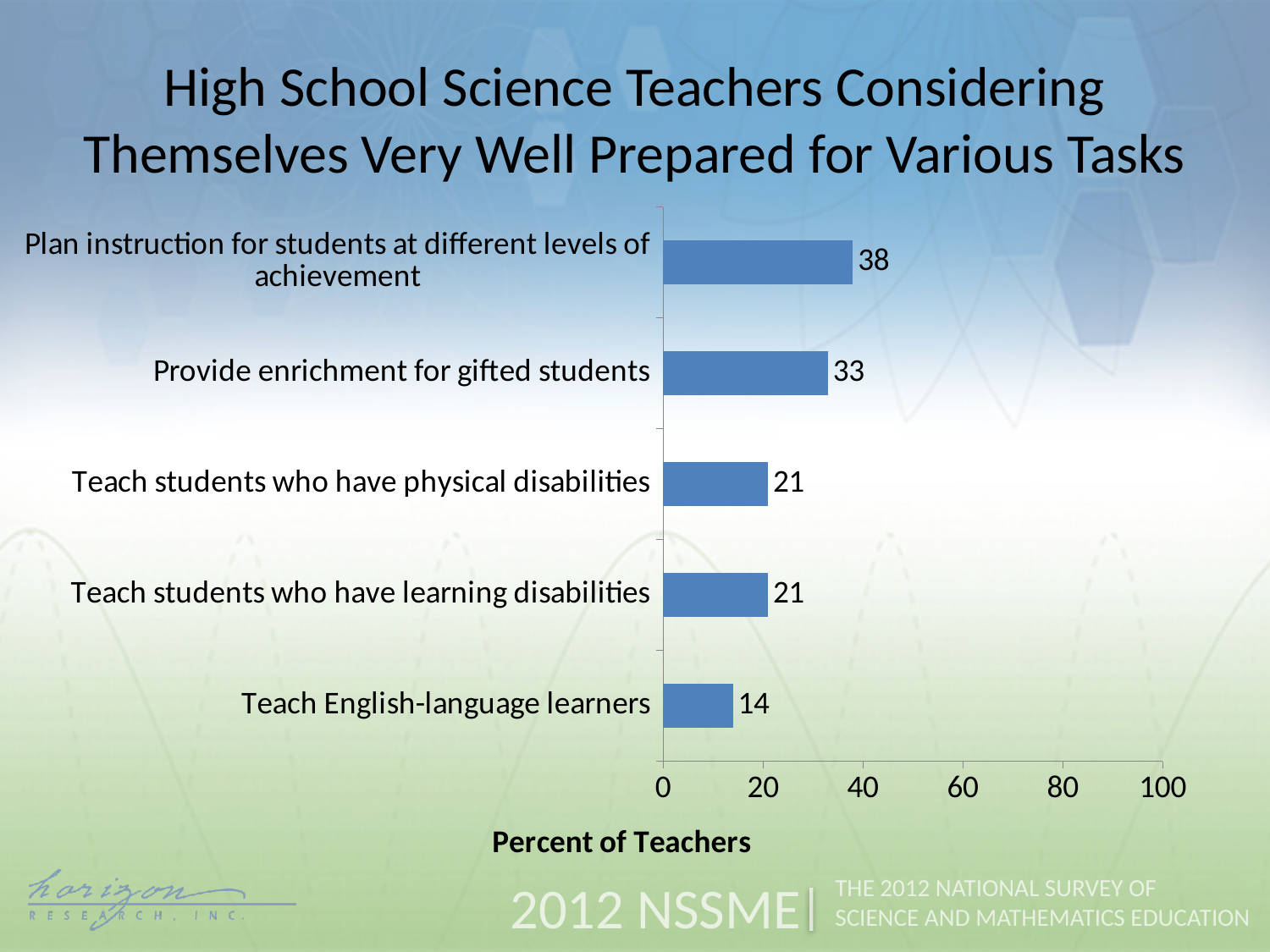
What percent of high school science teachers consider themselves very well prepared to plan instruction for students at different levels of achievement? 38 Which is larger: the value for 'Provide enrichment for gifted students' or the value for 'Teach students who have physical disabilities'? Provide enrichment for gifted students Which task has the highest percent of teachers considering themselves very well prepared? Plan instruction for students at different levels of achievement Is the value for 'Provide enrichment for gifted students' greater or less than 40? less What kind of chart is shown on the slide? Bar chart How many tasks are shown in the chart? 5 What is the value for 'Provide enrichment for gifted students'? 33 What is the value for 'Teach English-language learners'? 14 What is the label of the horizontal axis? Percent of Teachers What is the value for 'Teach students who have learning disabilities'? 21 Which task has the lowest percent of teachers considering themselves very well prepared? Teach English-language learners What is the difference between the values for 'Plan instruction for students at different levels of achievement' and 'Teach English-language learners'? 24